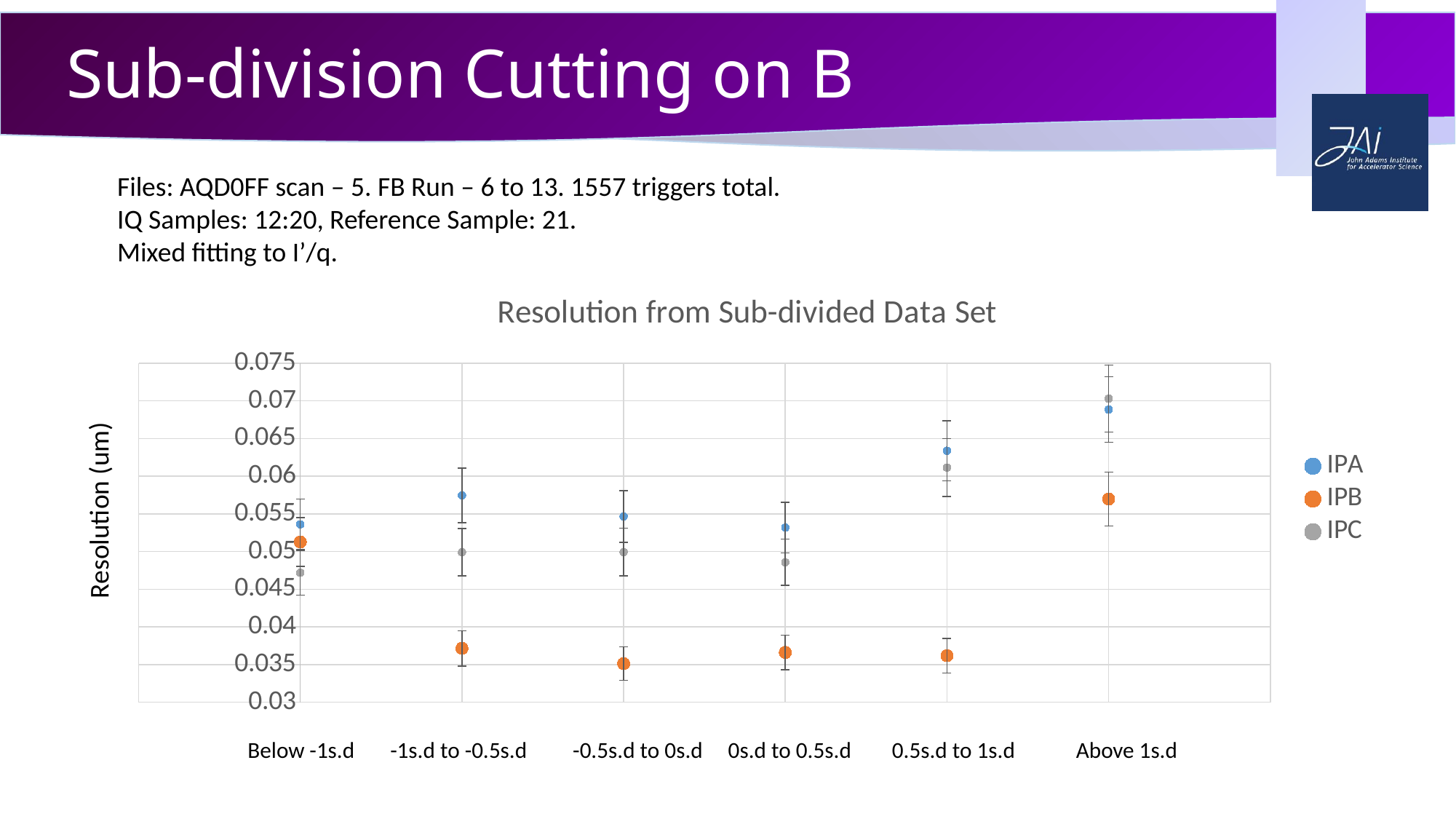
Is the IPA value for 0.5s.d to 1s.d greater or less than 0.06? greater How many series does the legend list? 3 Is the IPC value for Below -1s.d greater or less than 0.05? less How many categories are shown along the x axis? 6 What is the label on the y axis? Resolution (um) Is the IPB value for Above 1s.d greater or less than 0.05? greater Which is larger for Below -1s.d, IPB or IPC? IPB For which category is the IPA value highest? Above 1s.d What is the title of the chart? Resolution from Sub-divided Data Set For which category is the IPB value highest? Above 1s.d What kind of chart is shown on the slide? scatter chart Which is larger for -1s.d to -0.5s.d, IPA or IPB? IPA